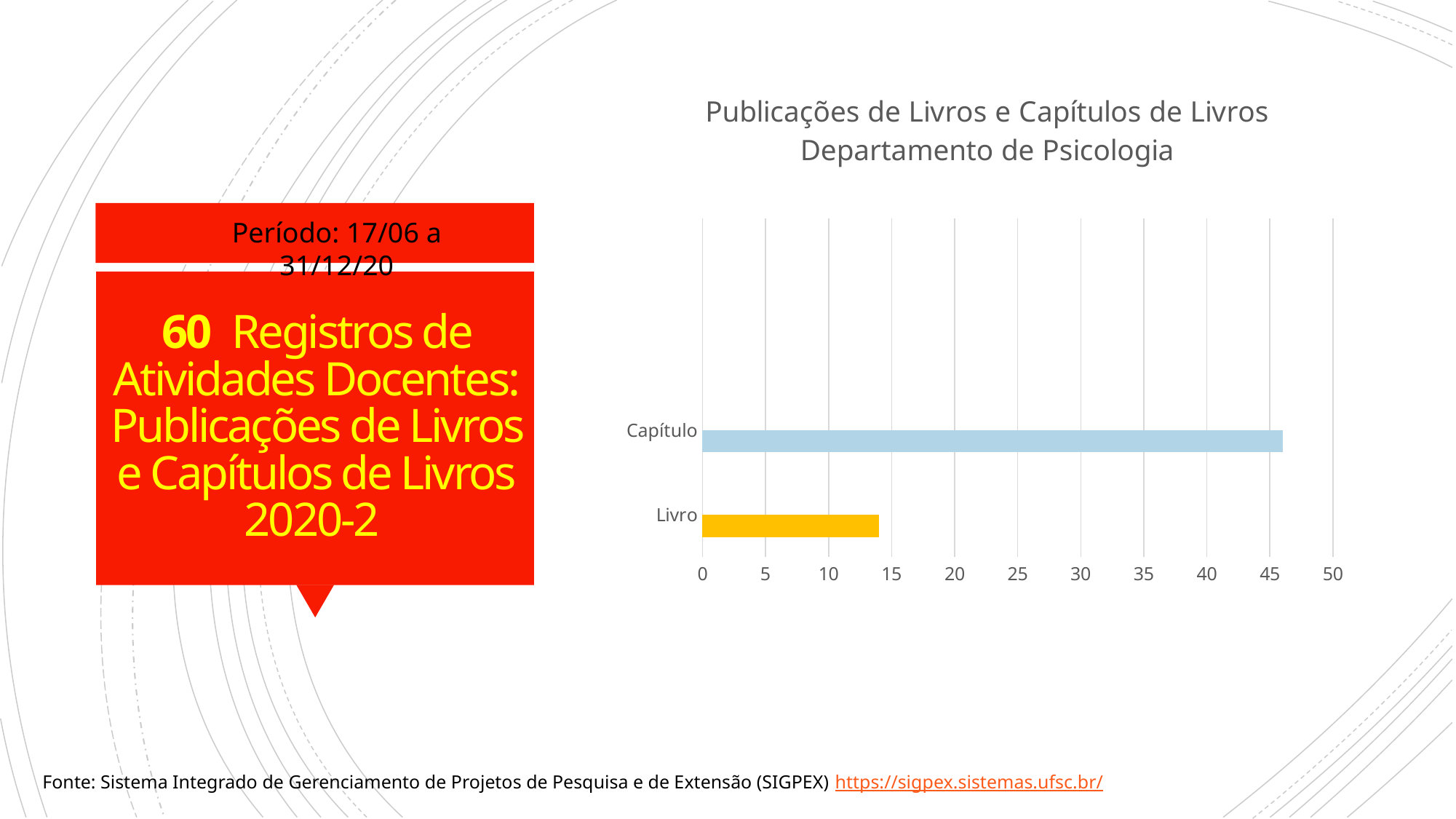
What kind of chart is shown on the slide? bar chart Is the value for Capítulo greater or less than 50? less Which category has the lowest value in the chart? Livro Is the value for Livro greater or less than 15? less Is the value for Capítulo greater or less than 40? greater What colour is the bar for Livro? orange/yellow What is the title of the chart? Publicações de Livros e Capítulos de Livros Departamento de Psicologia Which category has the highest value in the chart? Capítulo Which is larger, the value for Capítulo or the value for Livro? Capítulo How many categories are plotted in the chart? 2